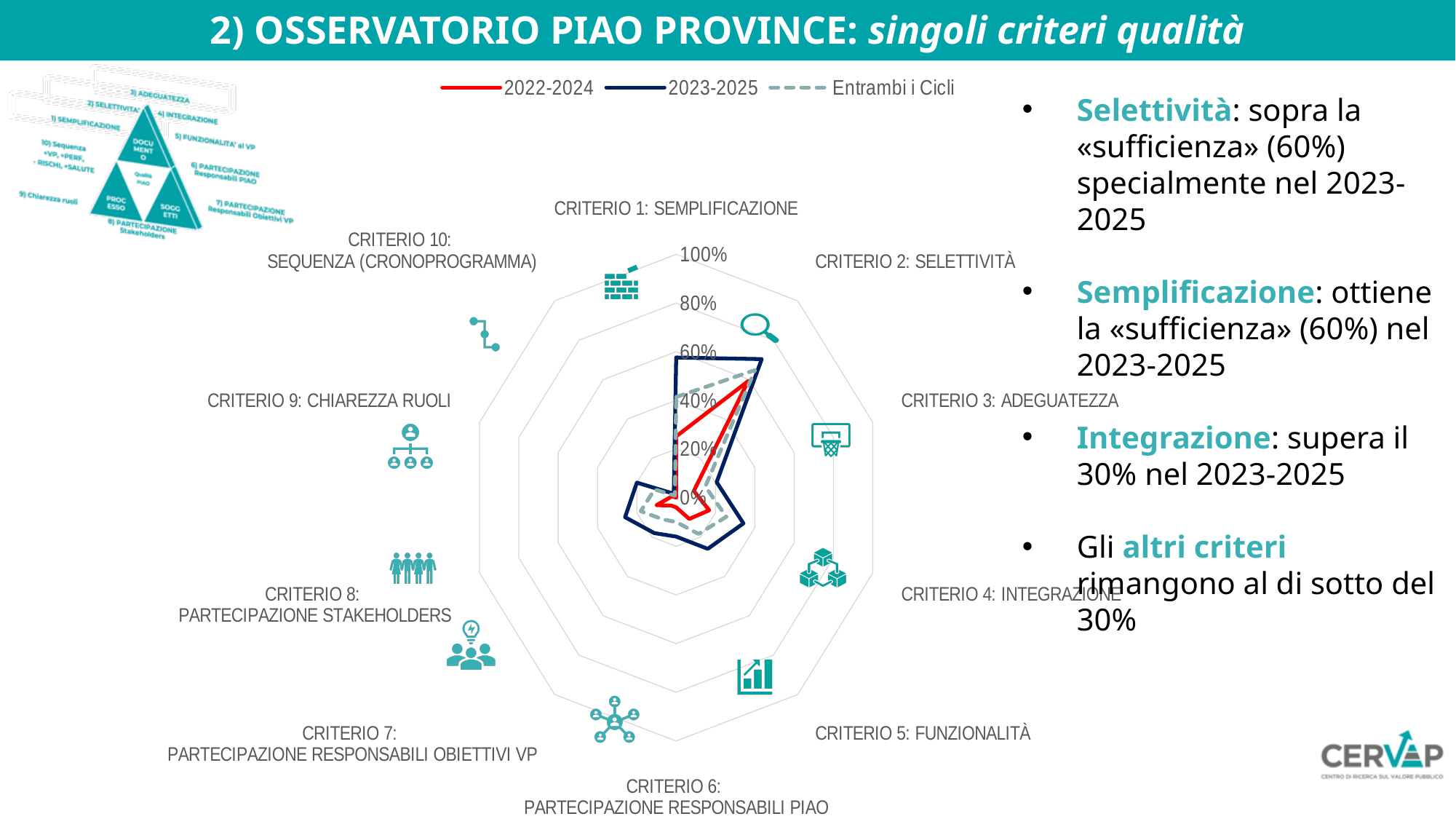
Is the 2023-2025 value for CRITERIO 1: SEMPLIFICAZIONE greater or less than 40%? greater What kind of chart is shown on the slide? Radar chart How many criteria (categories) are plotted on the radar chart? 10 How many series does the legend of the radar chart list? 3 What is the highest value shown on the radar chart's axis scale? 100% Which series are listed in the legend of the radar chart? 2022-2024, 2023-2025, Entrambi i Cicli Is the 2022-2024 value for CRITERIO 9: CHIAREZZA RUOLI greater or less than 40%? less For the 2022-2024 series, which criterion has the highest value? CRITERIO 2: SELETTIVITÀ Is the 2023-2025 value for CRITERIO 3: ADEGUATEZZA greater or less than 40%? less For CRITERIO 1: SEMPLIFICAZIONE, which series has the larger value, 2022-2024 or 2023-2025? 2023-2025